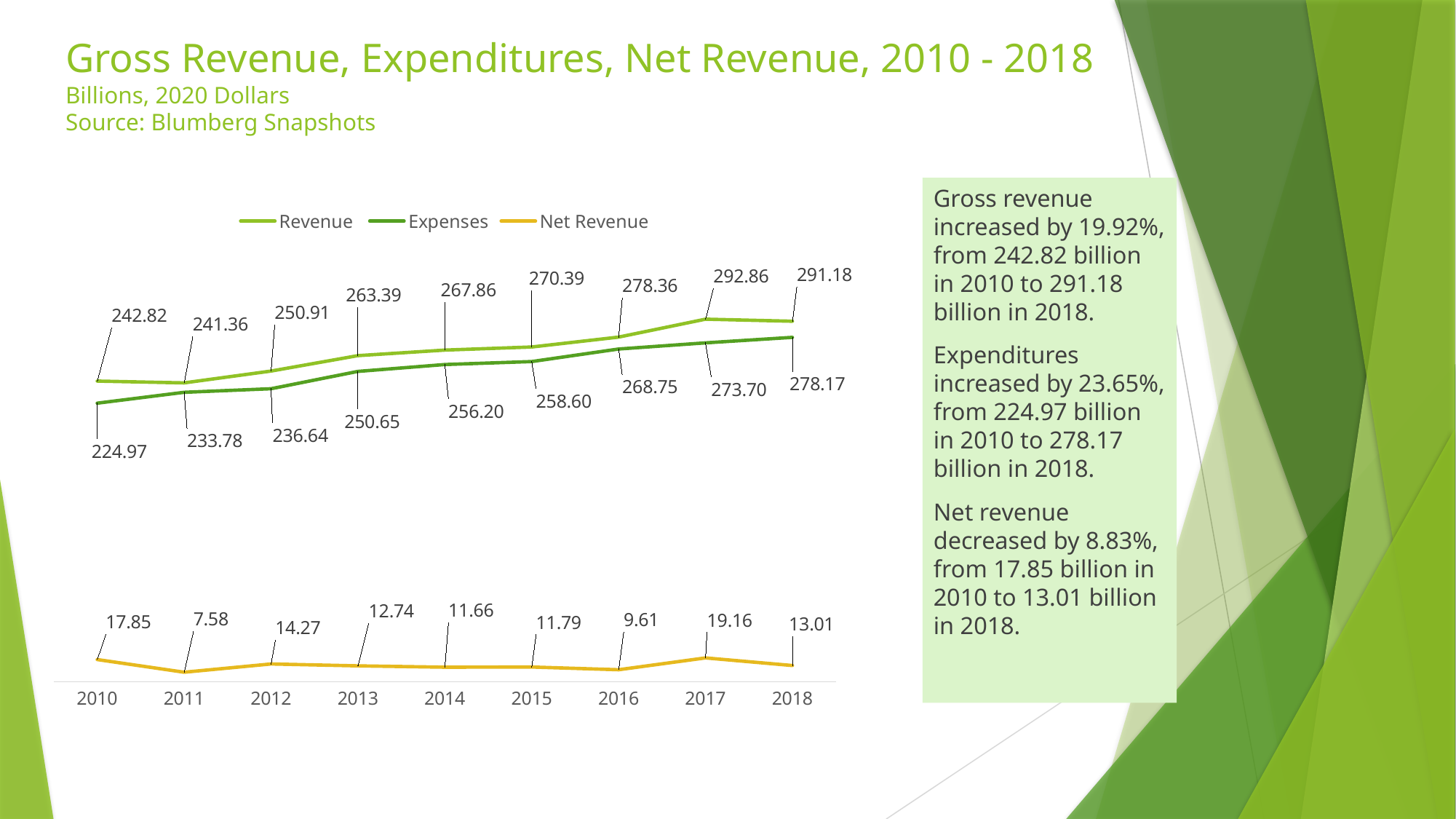
What type of chart is shown on the slide? Line chart How many series does the legend list? 3 In which year is Net Revenue lowest? 2011 What colour is the Net Revenue line? Orange What is the Revenue value for 2013? 263.39 Does the Expenses series rise or fall from 2010 to 2018? Rise Which is larger, Net Revenue in 2012 or Net Revenue in 2016? Net Revenue in 2012 What is the Net Revenue value for 2011? 7.58 How many years are plotted along the x axis? 9 What is the Expenses value for 2016? 268.75 In which year is Revenue highest? 2017 What is the difference between Revenue and Expenses in 2018? 13.01